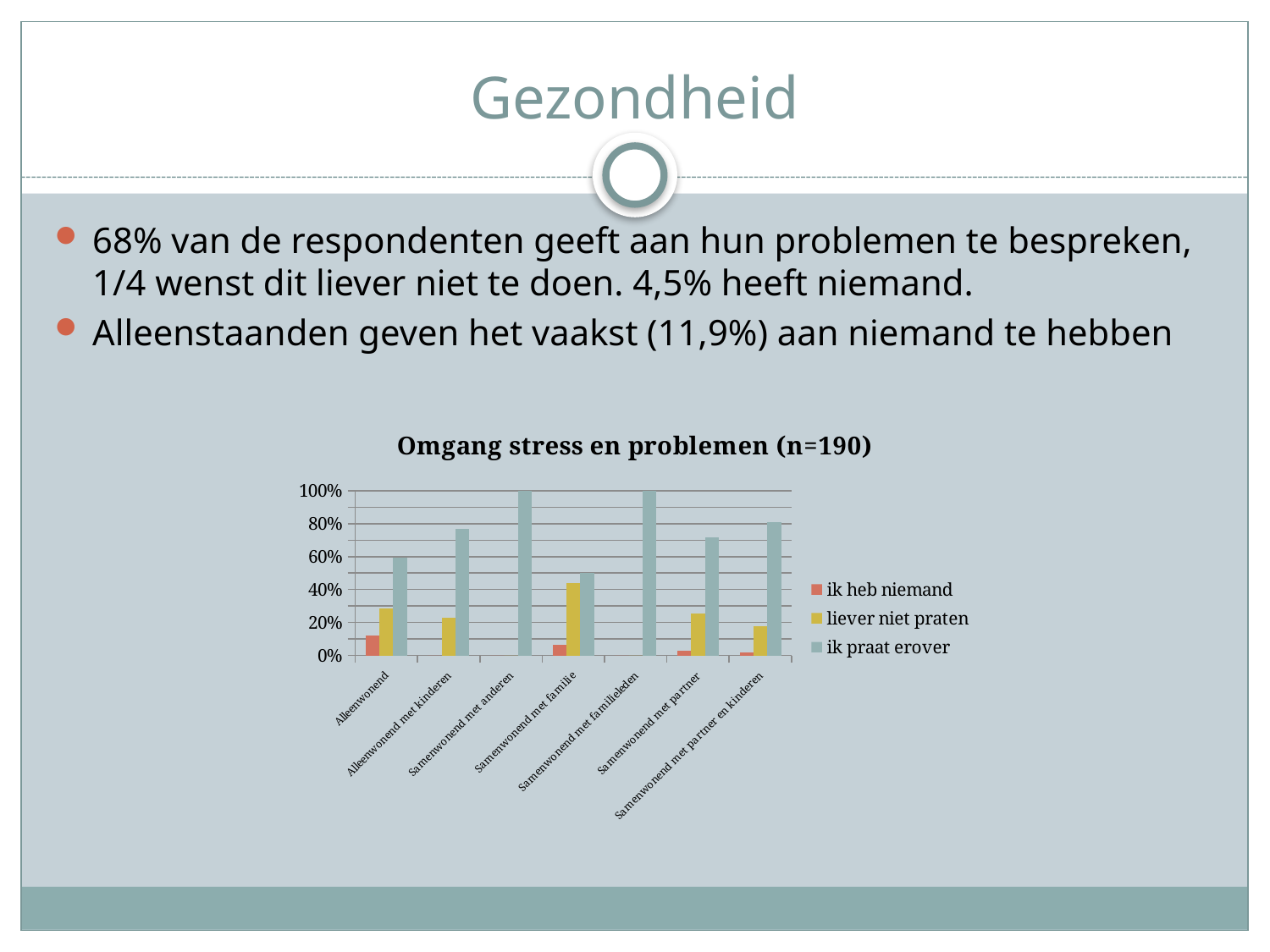
Is the value of 'ik heb niemand' for 'Alleenwonend' greater or less than 20%? less Is the value of 'liever niet praten' for 'Samenwonend met familie' greater or less than 40%? greater How many series does the chart's legend list? 3 What kind of chart is shown on the slide? bar chart What is the value of 'ik praat erover' for 'Samenwonend met anderen'? 100% Which category has the highest value for 'liever niet praten'? Samenwonend met familie Which category has the highest value for 'ik heb niemand'? Alleenwonend Is the value of 'ik praat erover' for 'Alleenwonend' greater or less than 80%? less What is the value of 'ik praat erover' for 'Samenwonend met familieleden'? 100% How many categories are shown on the x axis of the chart? 7 For 'Samenwonend met partner', which is larger: 'liever niet praten' or 'ik praat erover'? ik praat erover What is the title of the chart? Omgang stress en problemen (n=190)